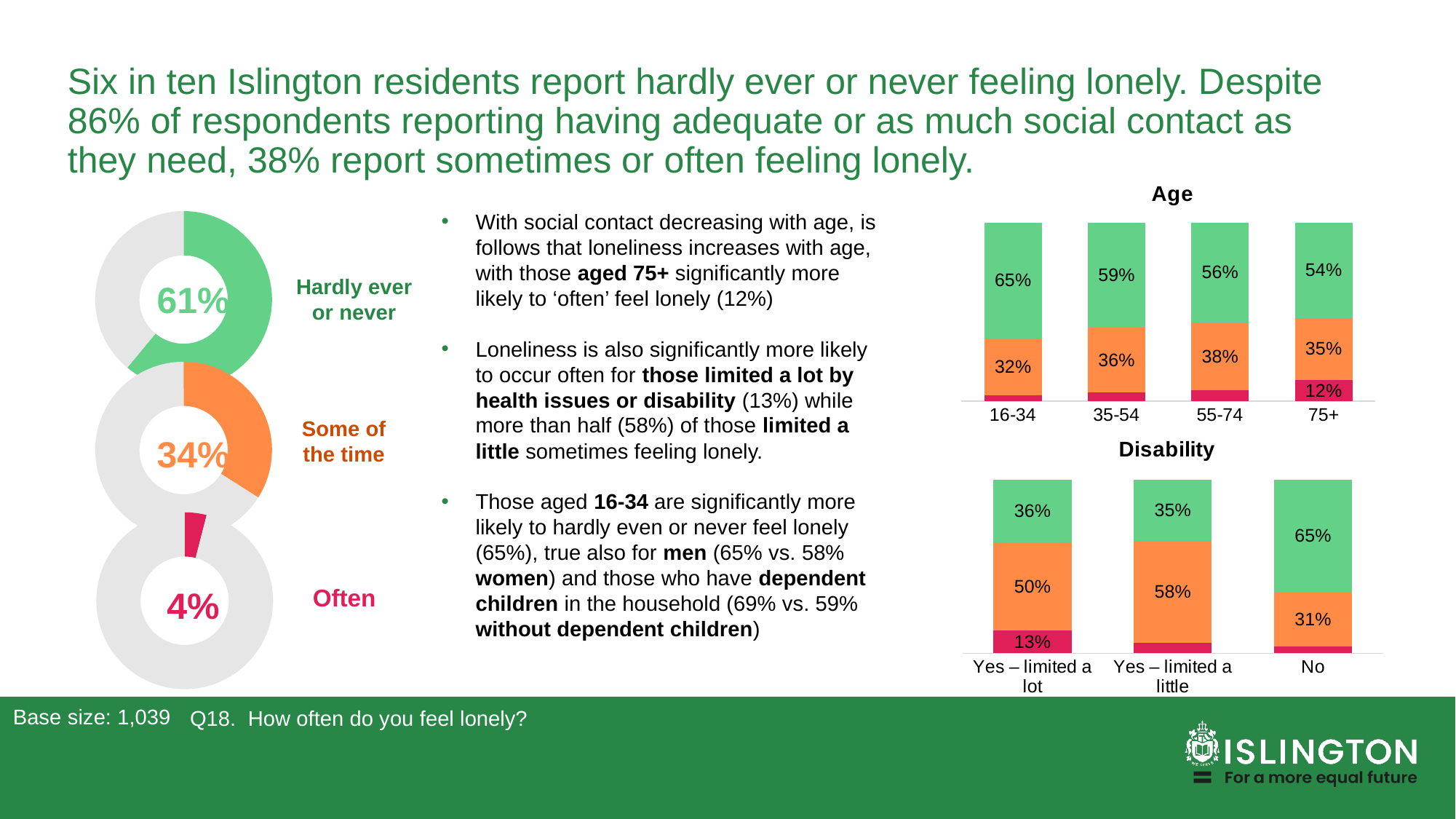
In the Age chart, which age group has the largest green (hardly ever or never) segment? 16-34 In the Disability chart, what is the difference between the orange segments for 'Yes – limited a little' and 'Yes – limited a lot'? 8 percentage points In the Disability chart, what is the value of the red (often) segment for 'Yes – limited a lot'? 13% How many age groups are shown in the Age chart? 4 In the Age chart, what is the value of the red (often) segment for the 75+ group? 12% In the Disability chart, what is the value of the orange (some of the time) segment for 'Yes – limited a little'? 58% What type of chart is the Disability chart? Stacked bar chart In the Age chart, what is the value of the green (hardly ever or never) segment for the 16-34 group? 65% In the Age chart, which is larger: the orange segment for 16-34 or for 55-74? 55-74 In the Disability chart, what is the value of the green (hardly ever or never) segment for 'No'? 65% In the Age chart, what is the value of the orange (some of the time) segment for the 55-74 group? 38% In the Age chart, does the green (hardly ever or never) segment rise or fall as age increases from 16-34 to 75+? Falls